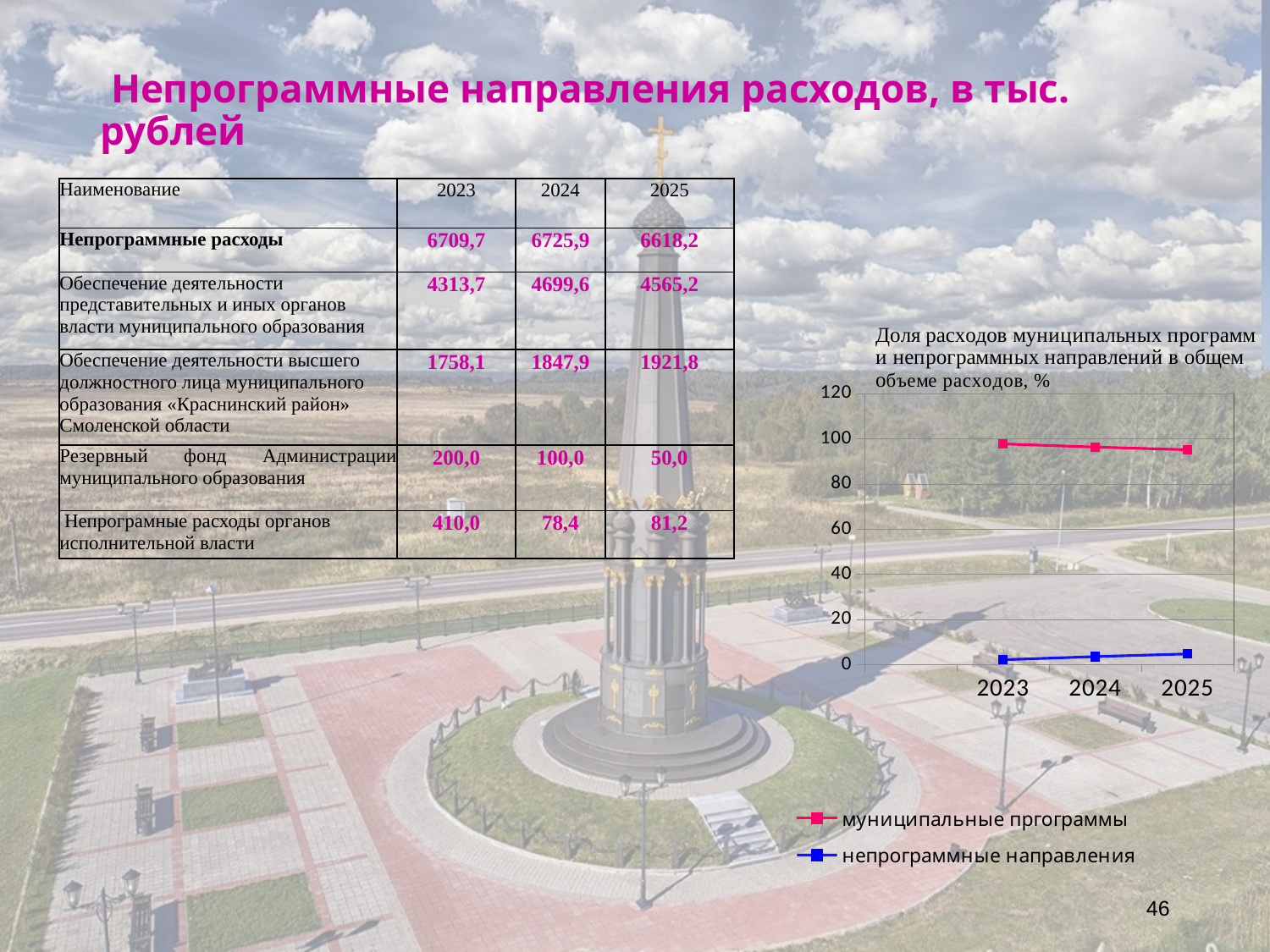
How many years are plotted along the x axis of the line chart? 3 In the line chart, is the value for непрограммные направления in 2025 greater or less than 20? less How many series does the legend of the line chart list? 2 In the line chart, do the values for муниципальные программы rise or fall from 2023 to 2025? fall In the line chart, is the value for муниципальные программы in 2025 greater or less than 60? greater What kind of chart is shown on the right side of the slide? line chart In the line chart, which year has the highest value for муниципальные программы? 2023 In the line chart, do the values for непрограммные направления rise or fall from 2023 to 2025? rise Which series in the line chart is drawn in blue? непрограммные направления In the line chart, which series has the larger value in 2024, муниципальные программы or непрограммные направления? муниципальные программы What is the title of the line chart? Доля расходов муниципальных программ и непрограммных направлений в общем объеме расходов, % In the line chart, is the value for муниципальные программы in 2023 greater or less than 80? greater